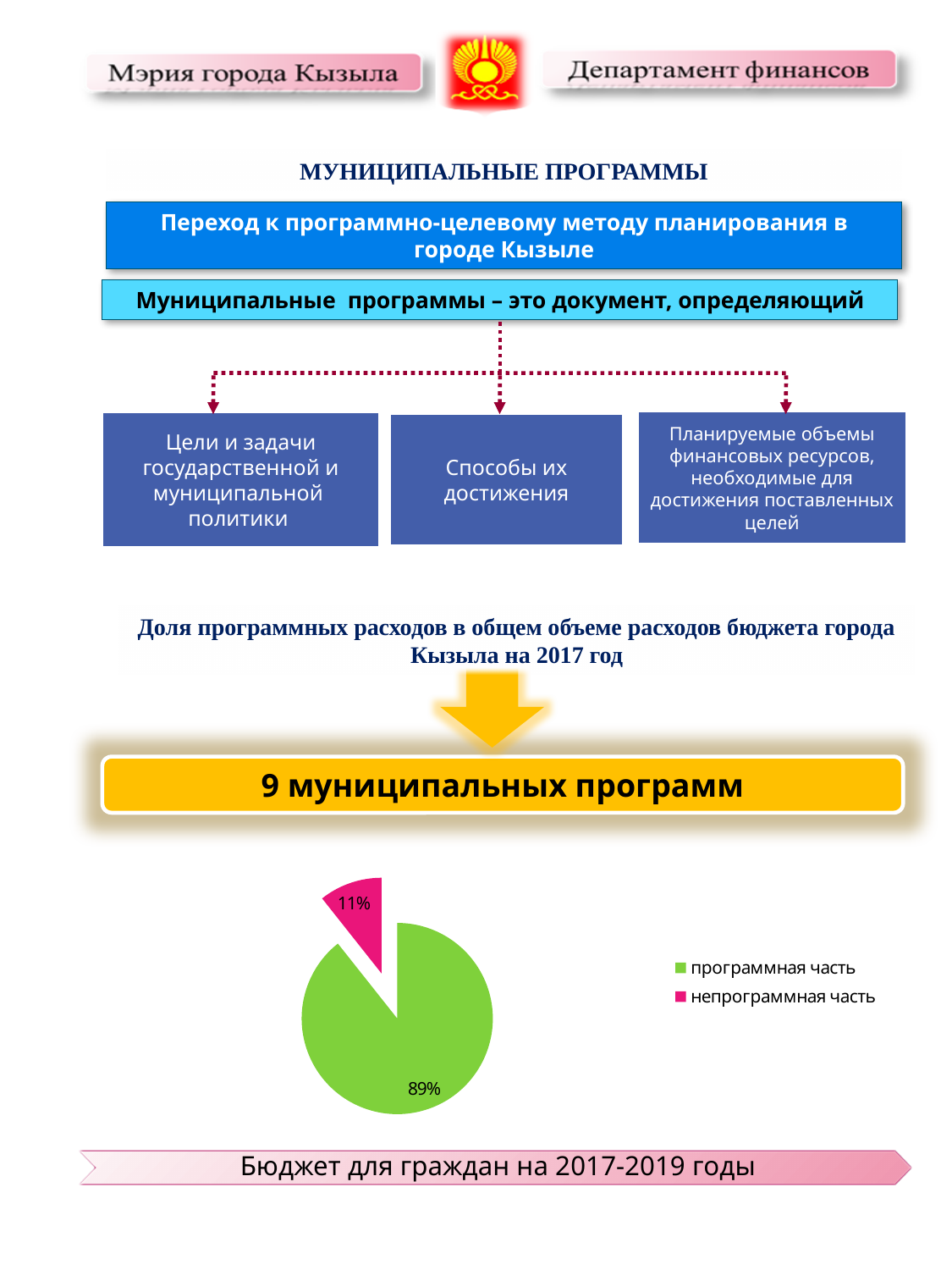
What kind of chart is shown on the slide? pie chart How many entries does the legend list? 2 What share of the pie does "непрограммная часть" take? 11% What is the difference in percentage points between "программная часть" and "непрограммная часть"? 78% What colour is the "непрограммная часть" slice? pink What colour is the "программная часть" slice? green Which slice of the pie is the smallest? непрограммная часть Which slice of the pie is the largest? программная часть How many slices does the pie chart have? 2 Which is larger, "программная часть" or "непрограммная часть"? программная часть What share of the pie does "программная часть" take? 89%